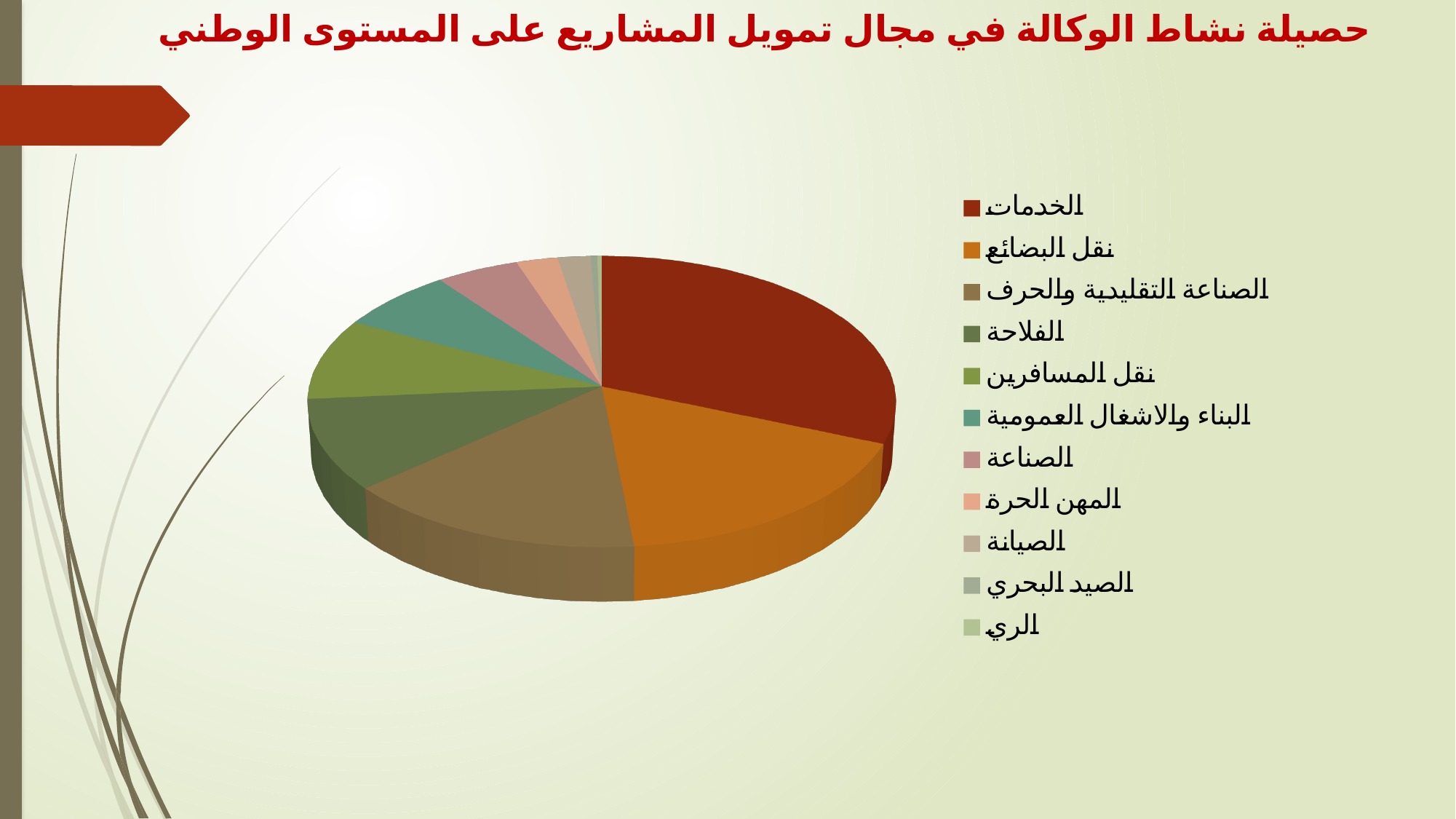
Which slice is larger, الخدمات or الفلاحة? الخدمات Which slice is larger, الصناعة التقليدية والحرف or البناء والاشغال العمومية? الصناعة التقليدية والحرف Which legend entry is shown in dark red? الخدمات How many categories does the pie chart's legend list? 11 What is the title of the chart slide? حصيلة نشاط الوكالة في مجال تمويل المشاريع على المستوى الوطني Which category has the largest slice of the pie chart? الخدمات Which slice is larger, نقل المسافرين or المهن الحرة? نقل المسافرين What kind of chart is shown on the slide? pie chart Which category is listed first in the legend? الخدمات